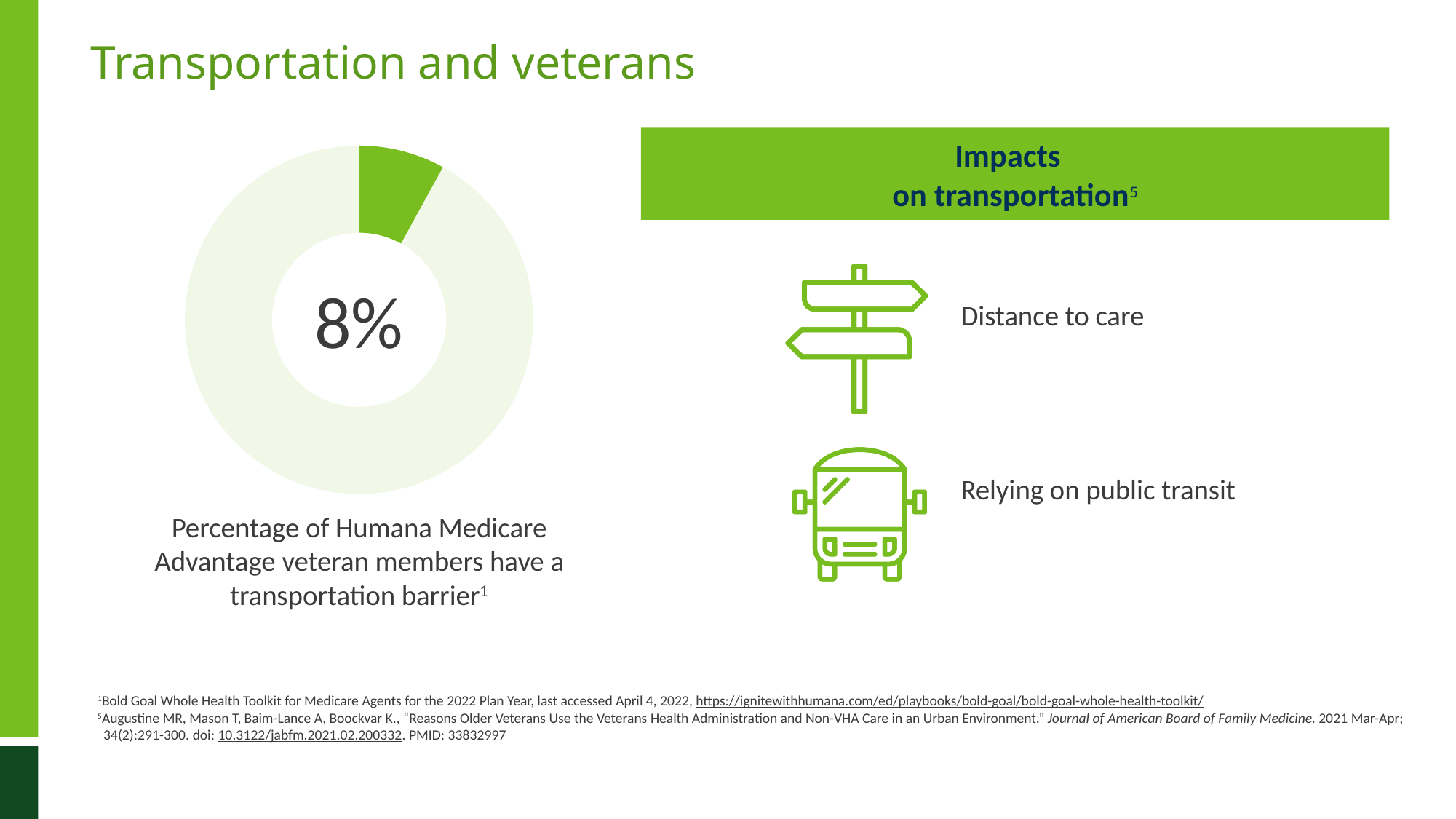
What share of the donut chart does the highlighted green slice represent? 8% How many segments does the donut chart have? 2 What percentage is displayed in the centre of the donut chart? 8% What colour is the highlighted slice of the donut chart? Green What kind of chart is shown on the left of the slide? Pie (donut) chart Which is larger in the donut chart: the highlighted green slice or the remaining light portion? The remaining light portion What does the 8% in the donut chart represent, according to the caption below it? Percentage of Humana Medicare Advantage veteran members have a transportation barrier Is the highlighted slice of the donut chart greater or less than 10%? less